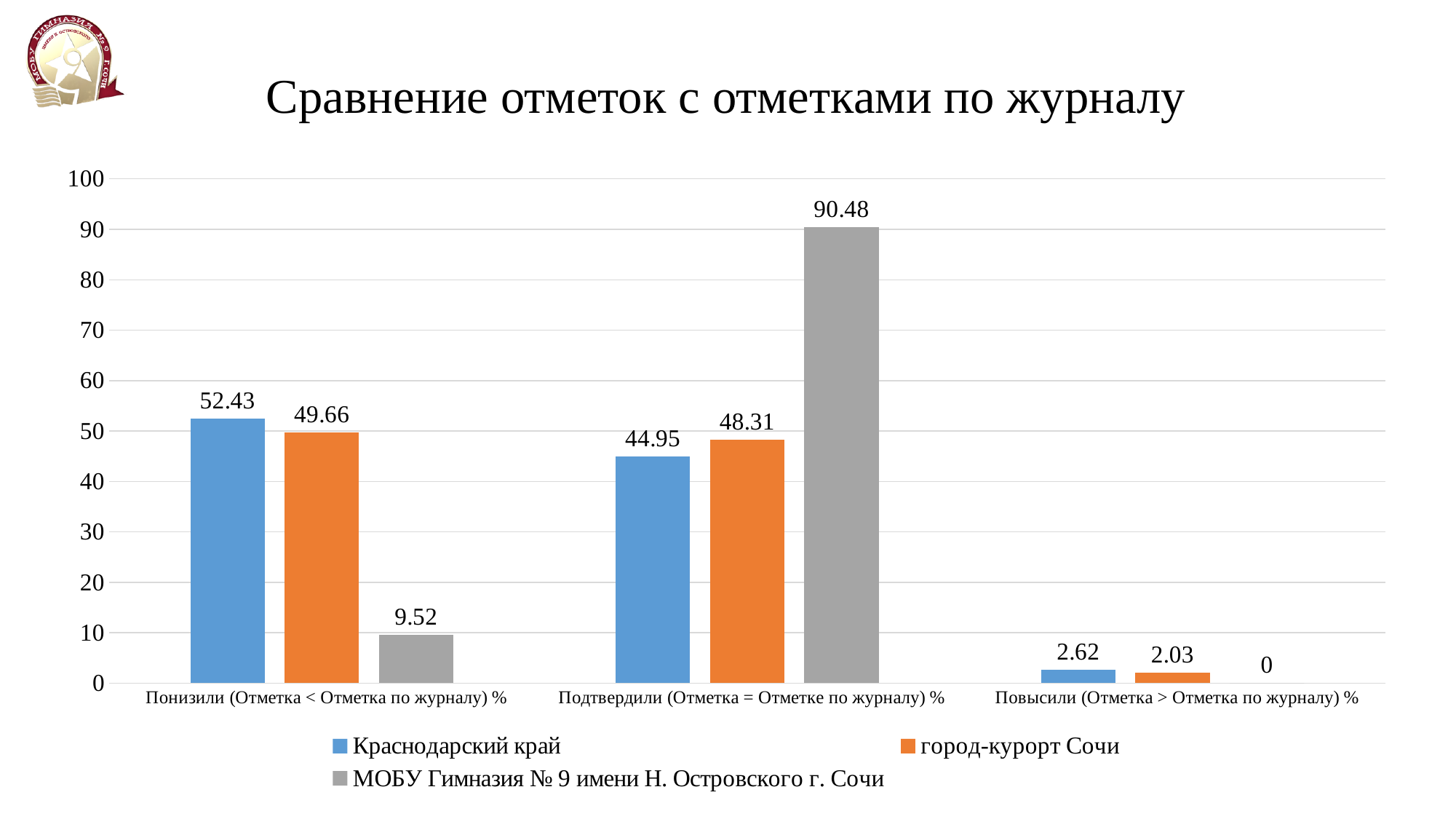
In the Подтвердили (Отметка = Отметке по журналу) % category, which is larger: Краснодарский край or город-курорт Сочи? город-курорт Сочи Is the value for МОБУ Гимназия № 9 имени Н. Островского г. Сочи in the Подтвердили category greater or less than 80? greater What kind of chart is shown on the slide? bar chart What is the value for город-курорт Сочи in the Повысили (Отметка > Отметка по журналу) % category? 2.03 Which series has the highest value in the Подтвердили (Отметка = Отметке по журналу) % category? МОБУ Гимназия № 9 имени Н. Островского г. Сочи How many categories are shown on the x axis? 3 What is the title of the chart? Сравнение отметок с отметками по журналу How many series does the legend list? 3 What is the value for Краснодарский край in the Понизили (Отметка < Отметка по журналу) % category? 52.43 Which series has the lowest value in the Понизили (Отметка < Отметка по журналу) % category? МОБУ Гимназия № 9 имени Н. Островского г. Сочи What is the difference between the Краснодарский край and город-курорт Сочи values in the Понизили (Отметка < Отметка по журналу) % category? 2.77 What is the value for МОБУ Гимназия № 9 имени Н. Островского г. Сочи in the Подтвердили (Отметка = Отметке по журналу) % category? 90.48